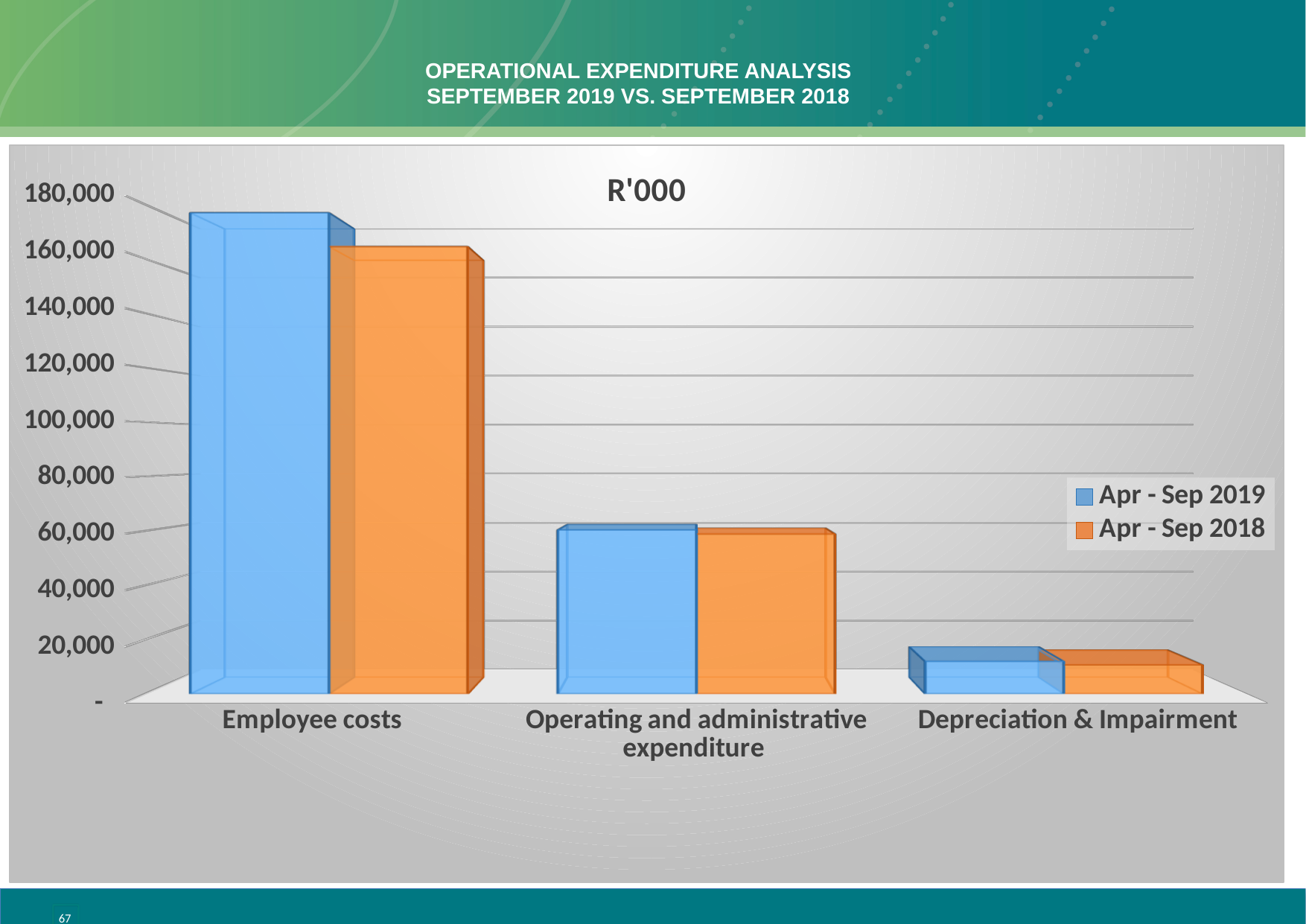
Is the Apr - Sep 2019 value for Operating and administrative expenditure greater or less than 80,000? less How many series does the chart's legend list? 2 What kind of chart is shown on the slide? bar chart How many categories are shown on the x axis of the chart? 3 What unit label is shown as the chart's title? R'000 Which category has the lowest values in the chart? Depreciation & Impairment Is the Apr - Sep 2018 value for Employee costs greater or less than 140,000? greater Which category has the highest values in the chart? Employee costs Do the values rise or fall moving from left to right across the categories? fall Is the Apr - Sep 2018 value for Depreciation & Impairment greater or less than 20,000? less For Employee costs, which is larger: the Apr - Sep 2019 value or the Apr - Sep 2018 value? Apr - Sep 2019